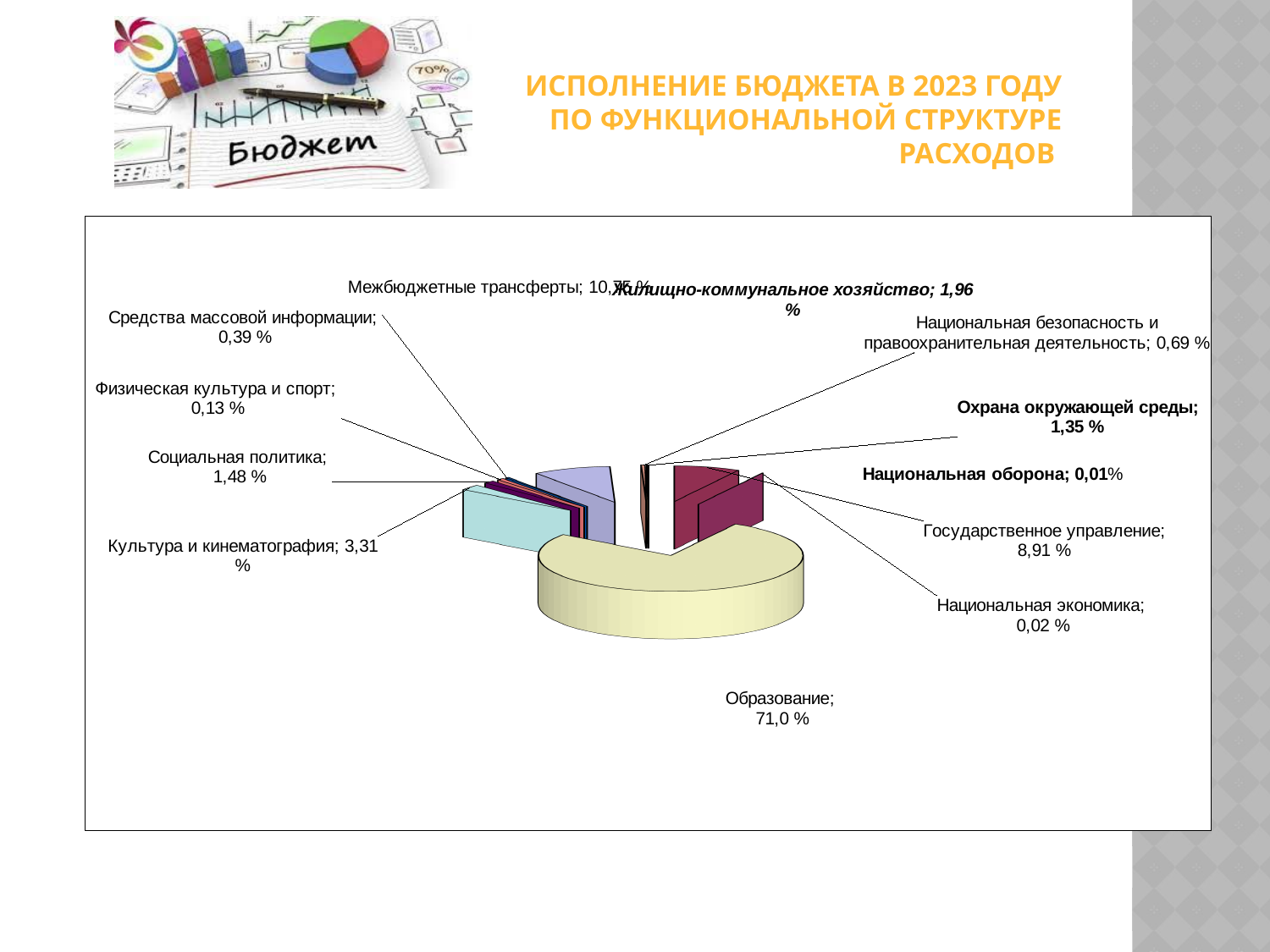
What value is shown for Социальная политика? 1,48 % How many categories are labelled on the pie chart? 12 What value is shown for Национальная экономика? 0,02 % What value is shown for Государственное управление? 8,91 % What is the difference between the values for Государственное управление and Культура и кинематография? 5,60 % What value is shown for Охрана окружающей среды? 1,35 % Which category has the smallest share of the pie? Национальная оборона Which is larger: the value for Жилищно-коммунальное хозяйство or the value for Средства массовой информации? Жилищно-коммунальное хозяйство What kind of chart is shown on the slide? Pie chart Which category has the largest share of the pie? Образование What share of expenditure is shown for Образование? 71,0 % What value is shown for Культура и кинематография? 3,31 %